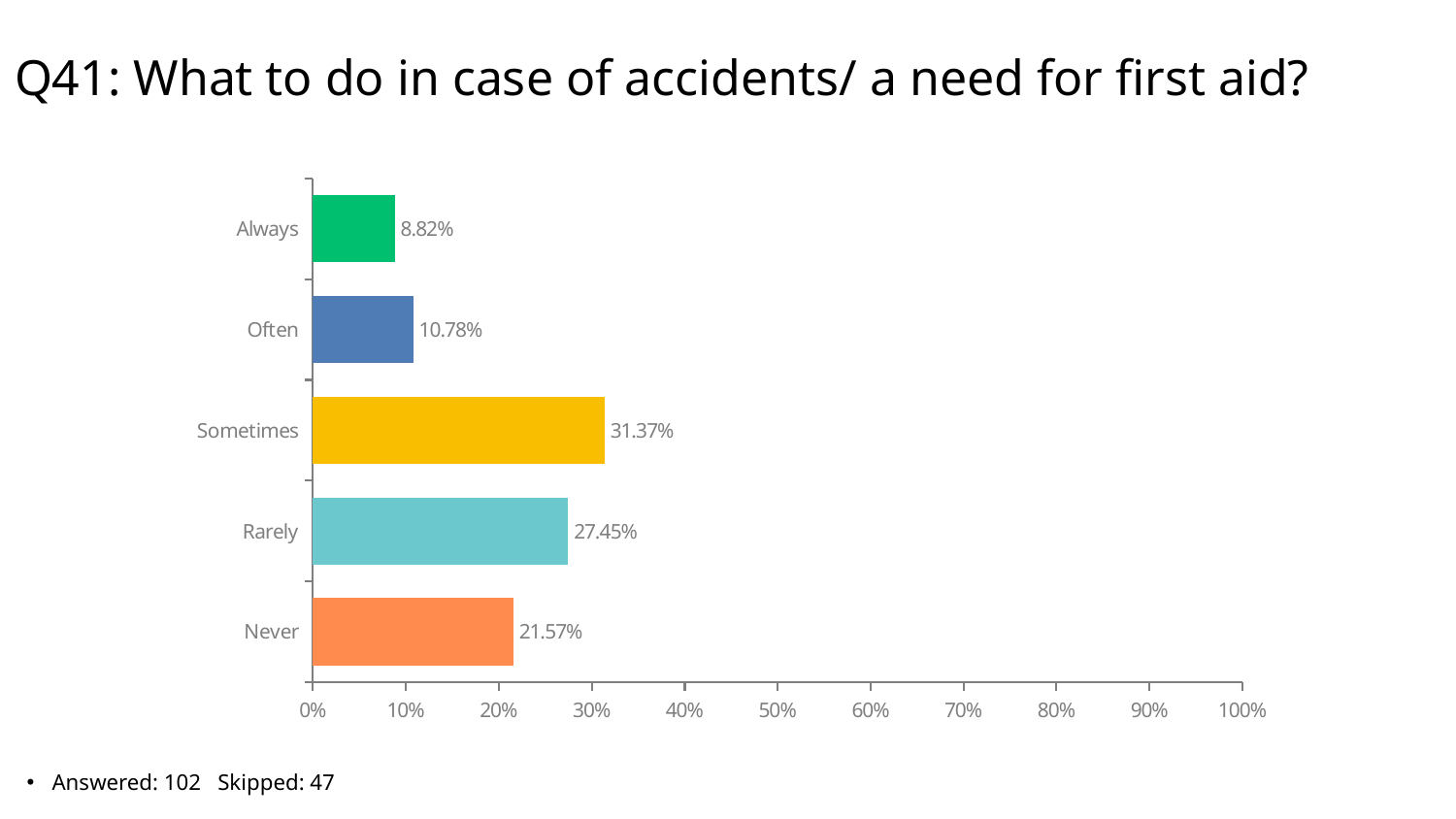
How many categories are shown in the chart? 5 Which category has the lowest value? Always What is the difference between the values for Often and Always? 1.96% What is the value for Always? 8.82% What is the value for Sometimes? 31.37% What colour is the bar for Sometimes? yellow Which category has the highest value? Sometimes Is the value for Sometimes greater or less than 30%? greater What is the difference between the values for Sometimes and Rarely? 3.92% Which is larger, the value for Rarely or the value for Never? Rarely What kind of chart is shown on the slide? bar chart What is the value for Never? 21.57%